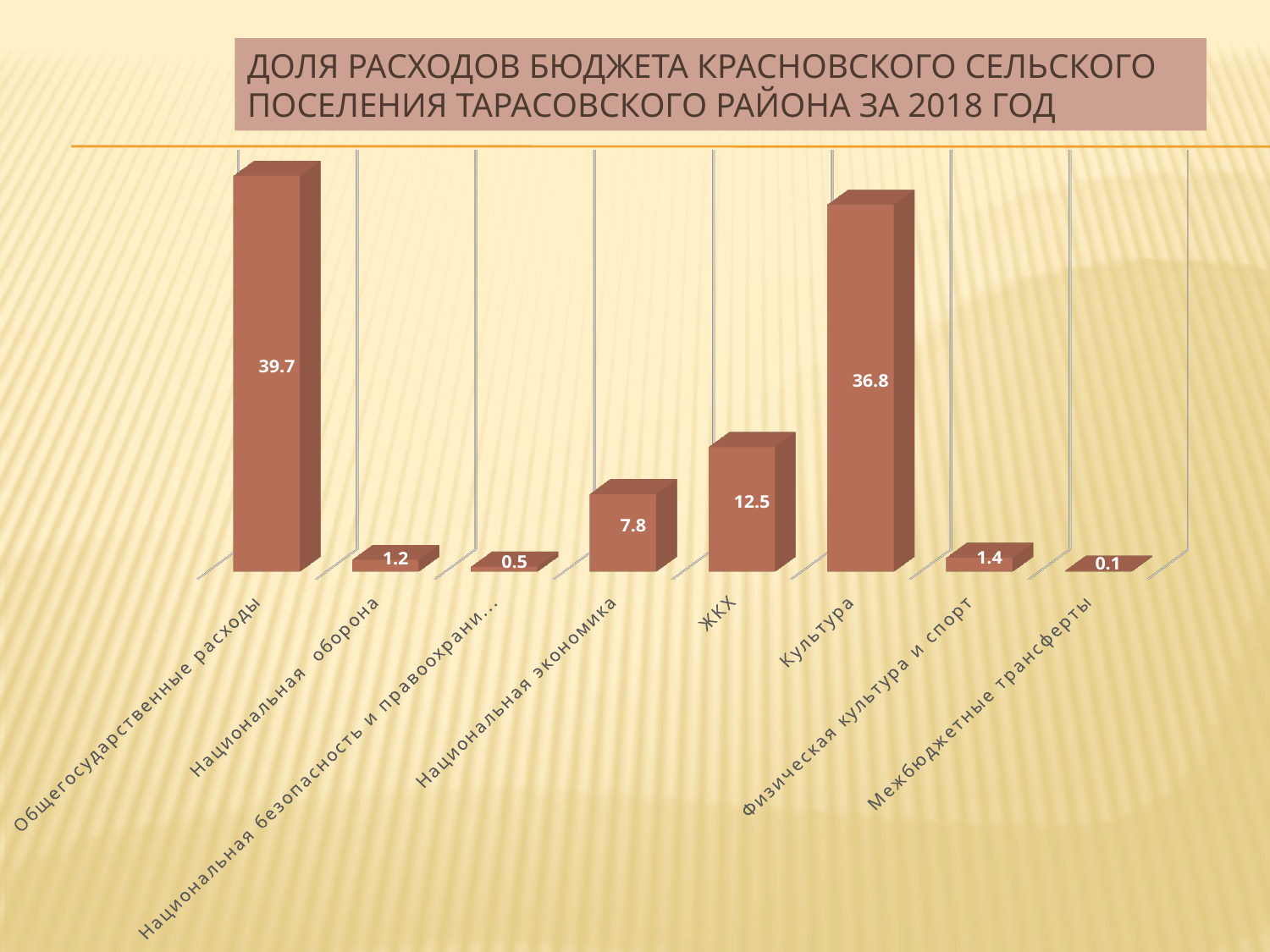
What is the value for Межбюджетные трансферты? 0.1 What is the value for Культура? 36.8 What is the value for Общегосударственные расходы? 39.7 What is the difference between the values for Физическая культура и спорт and Национальная оборона? 0.2 Which category has the highest value? Общегосударственные расходы How many categories are shown in the chart? 8 What is the value for Национальная экономика? 7.8 What is the value for ЖКХ? 12.5 What kind of chart is shown on the slide? Bar chart What is the difference between the values for Общегосударственные расходы and Культура? 2.9 Which is larger, the value for ЖКХ or the value for Национальная экономика? ЖКХ Which category has the lowest value? Межбюджетные трансферты